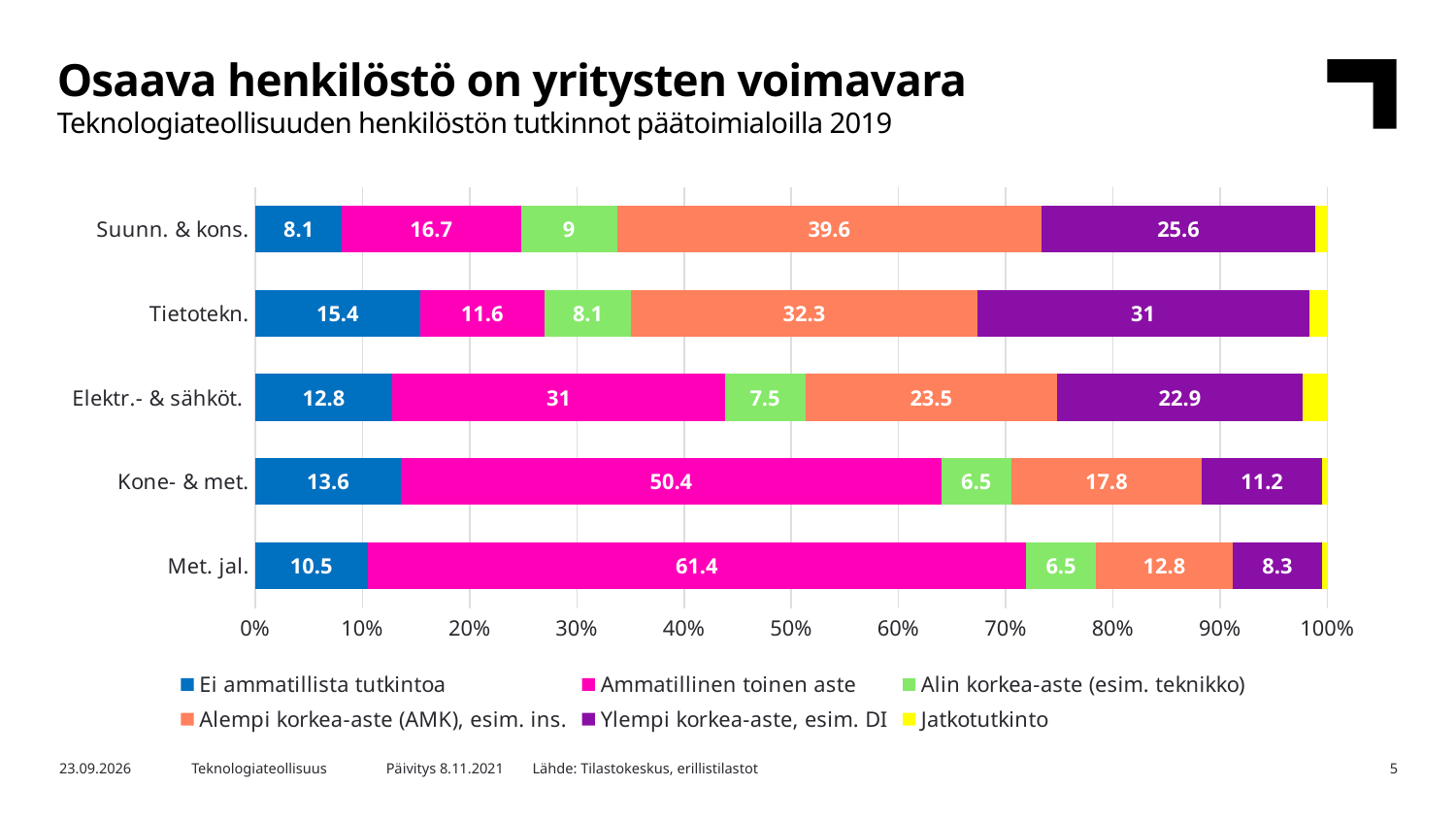
What is the value for Ammatillinen toinen aste in the Met. jal. bar? 61.4 What is the title of the chart on the slide? Osaava henkilöstö on yritysten voimavara Which category has the highest value for Ammatillinen toinen aste? Met. jal. How many categories are shown on the vertical axis? 5 What is the value for Ei ammatillista tutkintoa in the Kone- & met. bar? 13.6 Which category has the lowest value for Ylempi korkea-aste, esim. DI? Met. jal. What kind of chart is shown on the slide? Stacked bar chart How many series does the legend list? 6 What is the value for Alempi korkea-aste (AMK), esim. ins. in the Suunn. & kons. bar? 39.6 Which is larger: the Ei ammatillista tutkintoa value for Tietotekn. or for Suunn. & kons.? Tietotekn. What is the value for Ylempi korkea-aste, esim. DI in the Tietotekn. bar? 31 What is the difference between the Ammatillinen toinen aste values for Kone- & met. and Elektr.- & sähköt.? 19.4